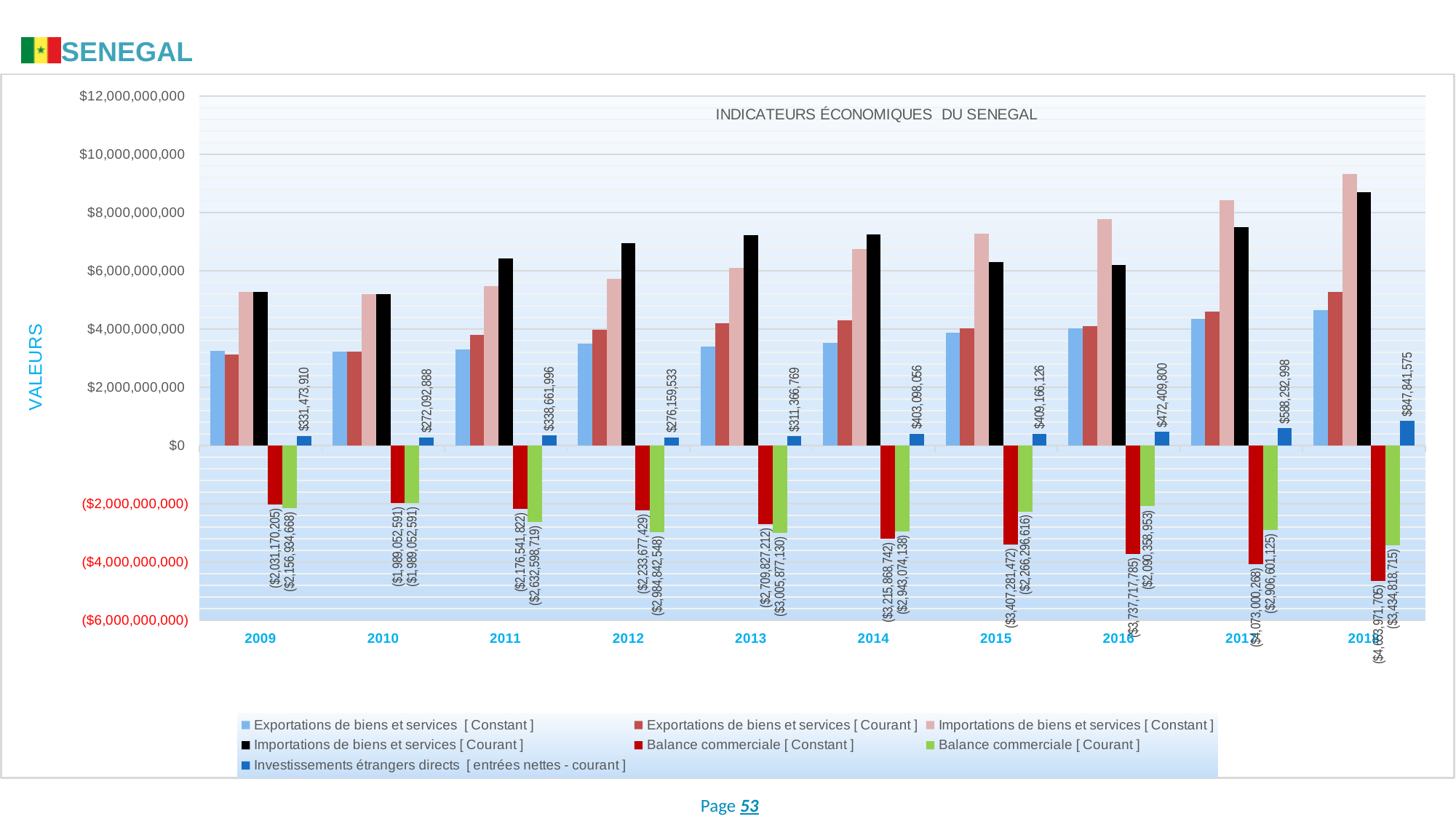
How many series does the chart's legend list? 7 What is the value of Investissements étrangers directs for 2009? $331,473,910 What is the title of the chart? INDICATEURS ÉCONOMIQUES DU SENEGAL In which year is Investissements étrangers directs highest? 2018 Is the value of Importations de biens et services [Courant] for 2018 greater or less than $8,000,000,000? greater How many years are shown on the x axis of the chart? 10 What is the value of Investissements étrangers directs for 2018? $847,841,575 Does Importations de biens et services [Constant] generally rise or fall from 2009 to 2018? rise What kind of chart is shown on the slide? bar chart What is the difference between Investissements étrangers directs in 2018 and in 2017? $259,548,577 What is the value of Balance commerciale [Constant] for 2017? ($4,073,000,268) In which year is Investissements étrangers directs lowest? 2010